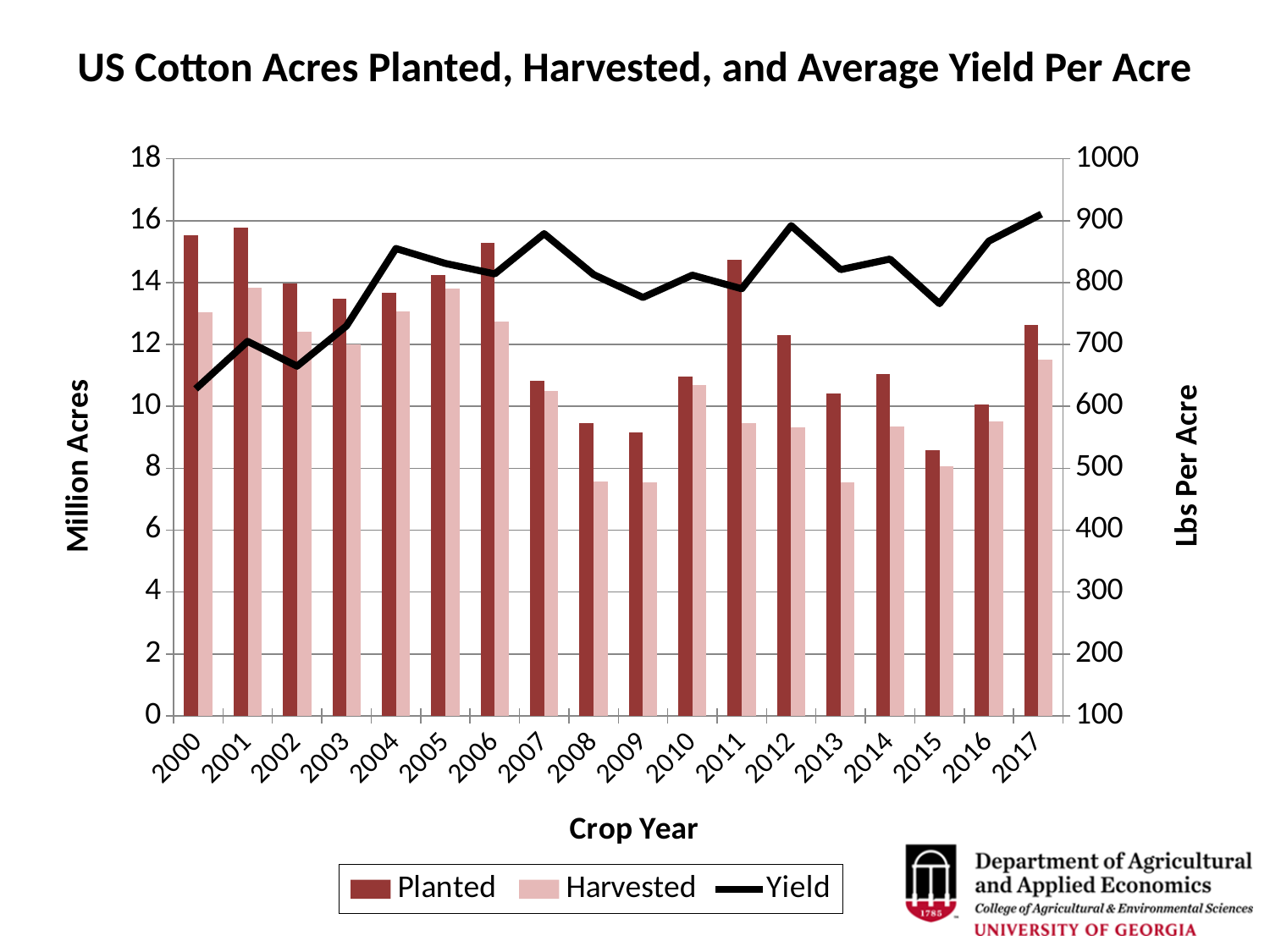
Does the Planted acreage rise or fall from 2006 to 2009? fall Is the Yield value for 2012 greater or less than 800 lbs per acre? greater Is the Yield value for 2000 greater or less than 700 lbs per acre? less Which crop year has the lowest Planted acreage? 2015 Which is larger, the Yield in 2004 or in 2002? 2004 Which crop year has the lowest Yield? 2000 Is the Planted value for 2015 greater or less than 10 million acres? less How many crop years are shown on the x axis? 18 What kind of chart is shown on the slide? A combination bar and line chart Which is larger, the Planted acreage in 2006 or in 2007? 2006 How many series does the legend list? 3